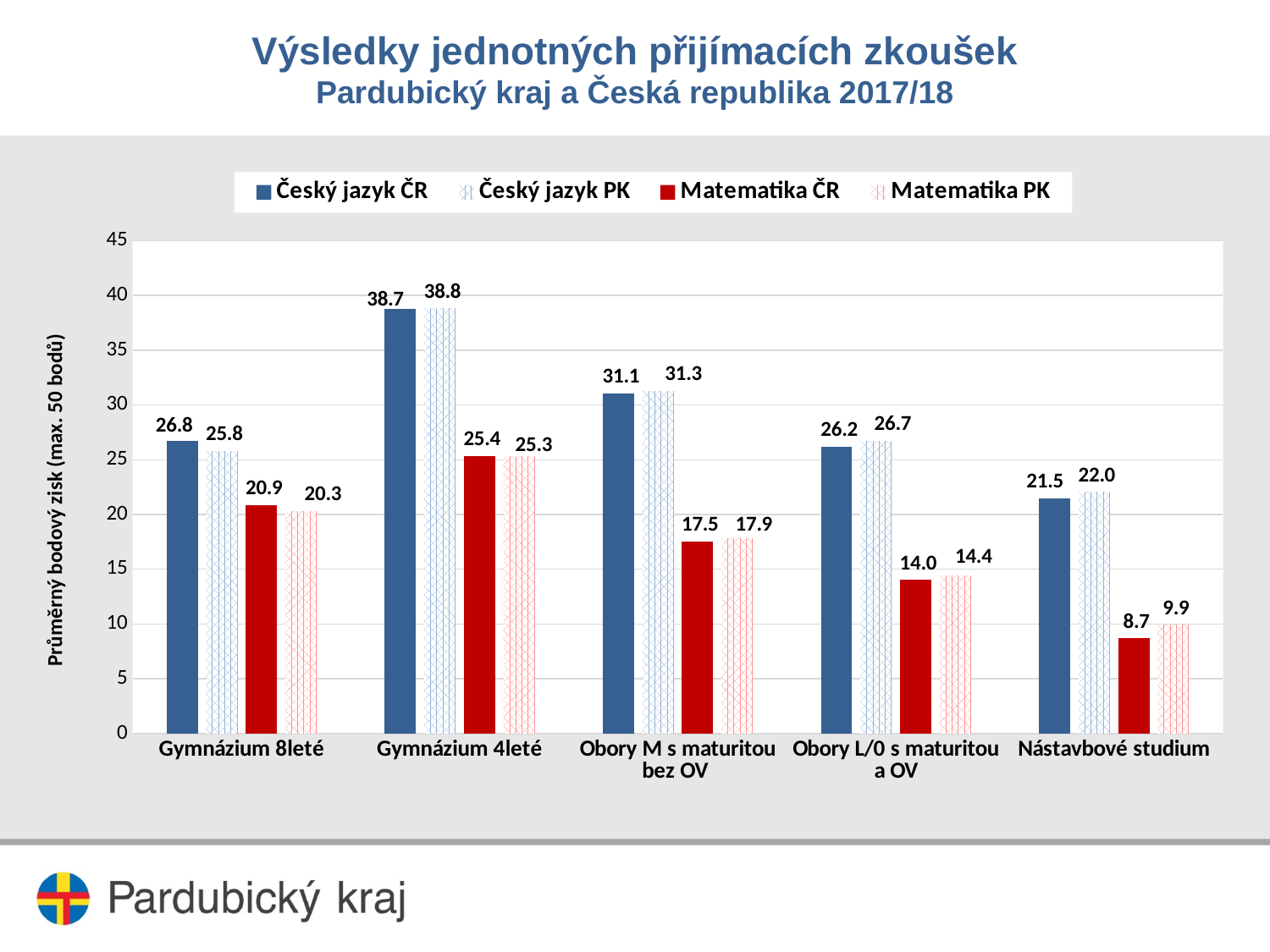
What is the label of the vertical axis? Průměrný bodový zisk (max. 50 bodů) Which category has the highest value for Český jazyk PK? Gymnázium 4leté What is the difference between Český jazyk ČR and Matematika ČR in the Gymnázium 8leté category? 5.9 Is the value for Český jazyk PK in the Nástavbové studium category greater or less than 25? less How many categories are shown on the x axis? 5 What is the value for Matematika PK in the Nástavbové studium category? 9.9 How many series does the legend list? 4 Which is larger in the Obory M s maturitou bez OV category: Matematika ČR or Matematika PK? Matematika PK Which category has the lowest value for Matematika ČR? Nástavbové studium What is the value for Matematika ČR in the Obory L/0 s maturitou a OV category? 14.0 What is the value for Český jazyk ČR in the Gymnázium 4leté category? 38.7 What kind of chart is shown on the slide? bar chart